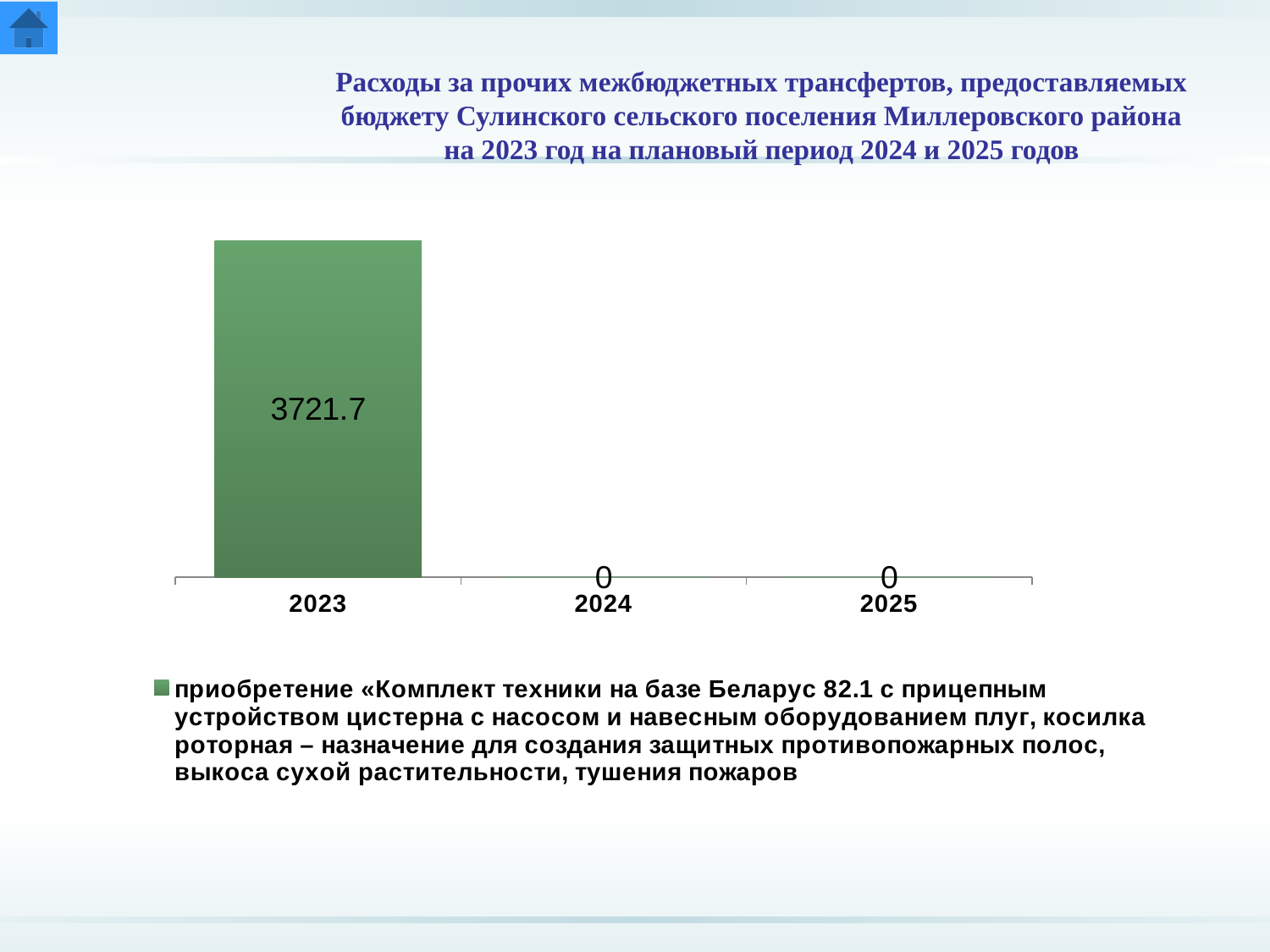
What colour are the bars in the chart? green What is the value for 2025? 0 What is the value for 2024? 0 What is the value for 2023? 3721.7 How many years are shown on the x axis? 3 Which year has the highest value? 2023 Which is larger, the value for 2023 or the value for 2025? 2023 Do the values rise or fall from 2023 to 2024? fall What kind of chart is shown on the slide? bar chart What is the difference between the values for 2023 and 2024? 3721.7 What is the total of the values for 2023, 2024 and 2025? 3721.7 How many series does the legend list? 1